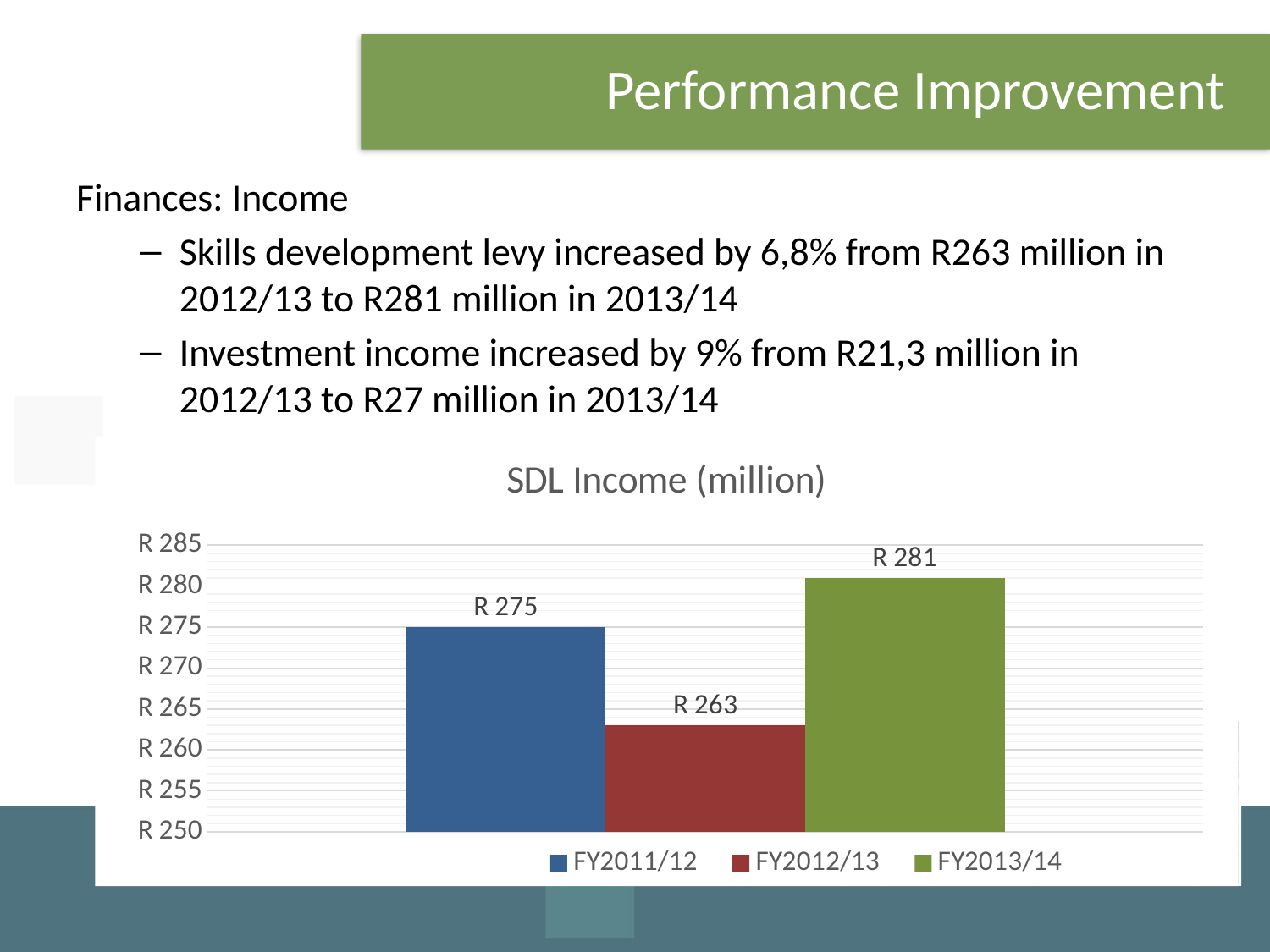
Which financial year has the highest SDL Income? FY2013/14 What is the difference in SDL Income between FY2013/14 and FY2012/13? R 18 What kind of chart is used to show SDL Income? bar chart Which financial year has the lowest SDL Income? FY2012/13 What is the SDL Income value for FY2011/12? R 275 How many series does the legend of the SDL Income chart list? 3 What is the SDL Income value for FY2012/13? R 263 What is the SDL Income value for FY2013/14? R 281 What is the title of the chart on the slide? SDL Income (million) What is the difference in SDL Income between FY2011/12 and FY2012/13? R 12 Which is larger, the SDL Income for FY2011/12 or for FY2013/14? FY2013/14 Is the SDL Income for FY2012/13 greater or less than R 265? less